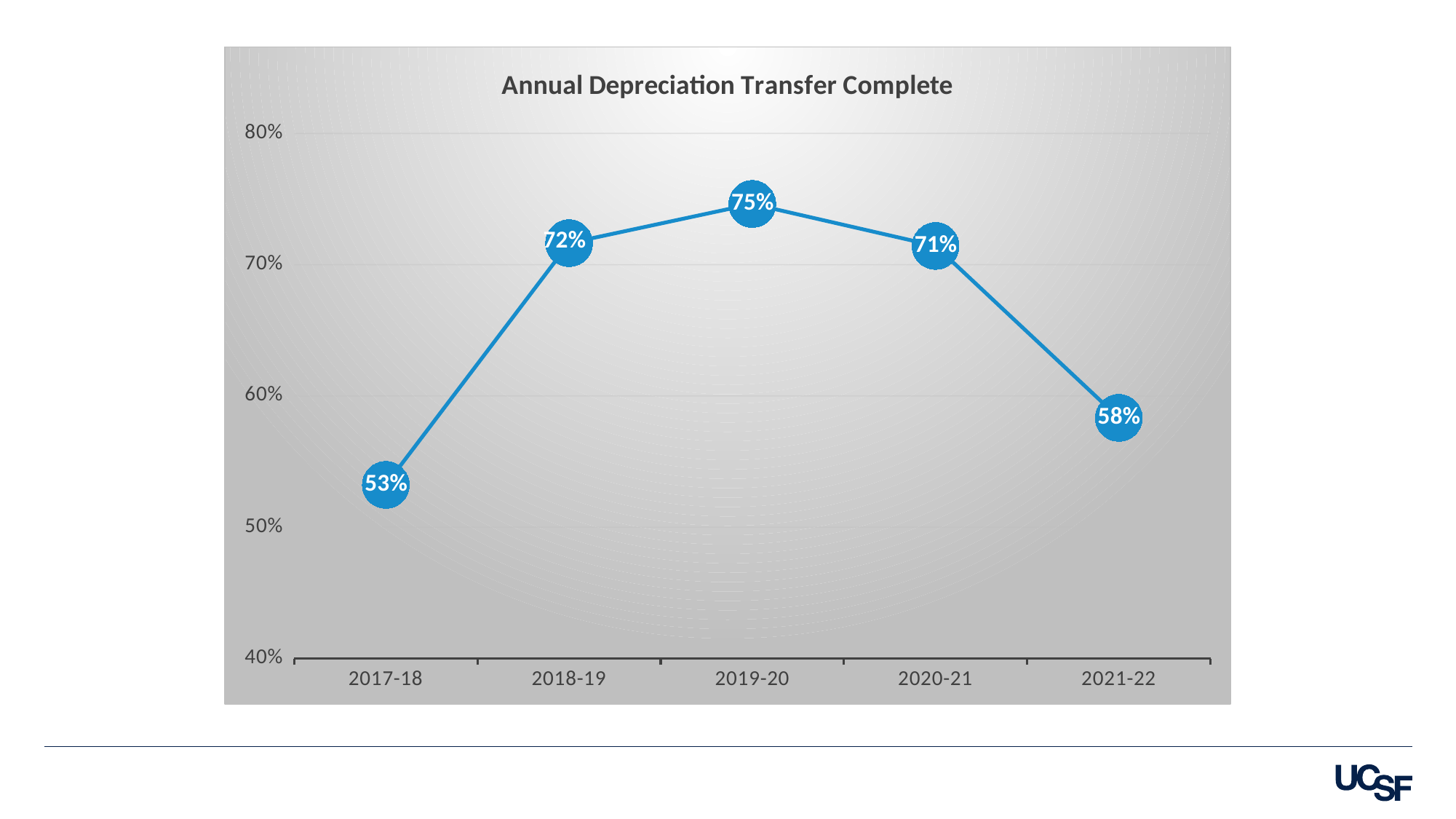
Is the value for 2020-21 greater or less than 60%? greater Which year has the lowest value? 2017-18 What is the difference between the values for 2019-20 and 2017-18? 22% How many years are plotted on the chart? 5 What is the value for 2021-22? 58% What is the value for 2019-20? 75% What is the value for 2017-18? 53% What is the difference between the values for 2020-21 and 2021-22? 13% Which is larger, the value for 2018-19 or the value for 2021-22? 2018-19 Which year has the highest value? 2019-20 What is the title of the chart? Annual Depreciation Transfer Complete What kind of chart is shown? line chart